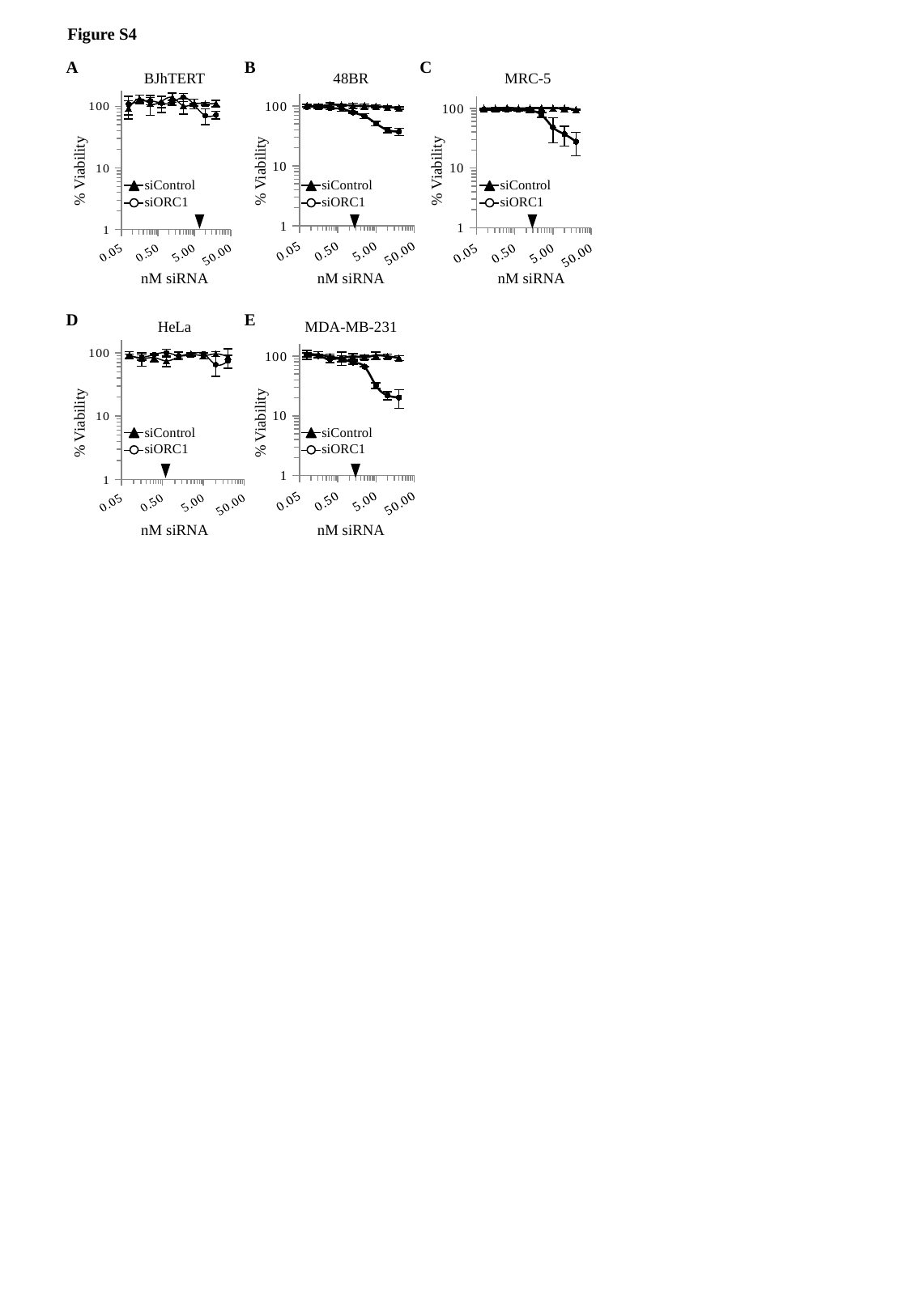
In the MRC-5 chart, at the highest siRNA concentration, is the siORC1 viability greater or less than 100? less In the 48BR chart, does the siORC1 viability rise or fall as nM siRNA increases? fall In the MDA-MB-231 chart, does the siORC1 viability rise or fall as nM siRNA increases? fall How many series does the legend of the 48BR chart list? 2 In the MRC-5 chart, does the siORC1 viability rise or fall as nM siRNA increases? fall What is the y-axis label of the HeLa chart? % Viability In the MDA-MB-231 chart, at the highest siRNA concentration, which series has the higher viability, siControl or siORC1? siControl In the 48BR chart, at the highest siRNA concentration, is the siORC1 viability greater or less than 100? less How many charts are shown on the slide? 5 In the MDA-MB-231 chart, at the highest siRNA concentration, is the siORC1 viability greater or less than 10? greater What kind of chart is the BJhTERT chart? line chart What are the two legend entries in the MRC-5 chart? siControl and siORC1